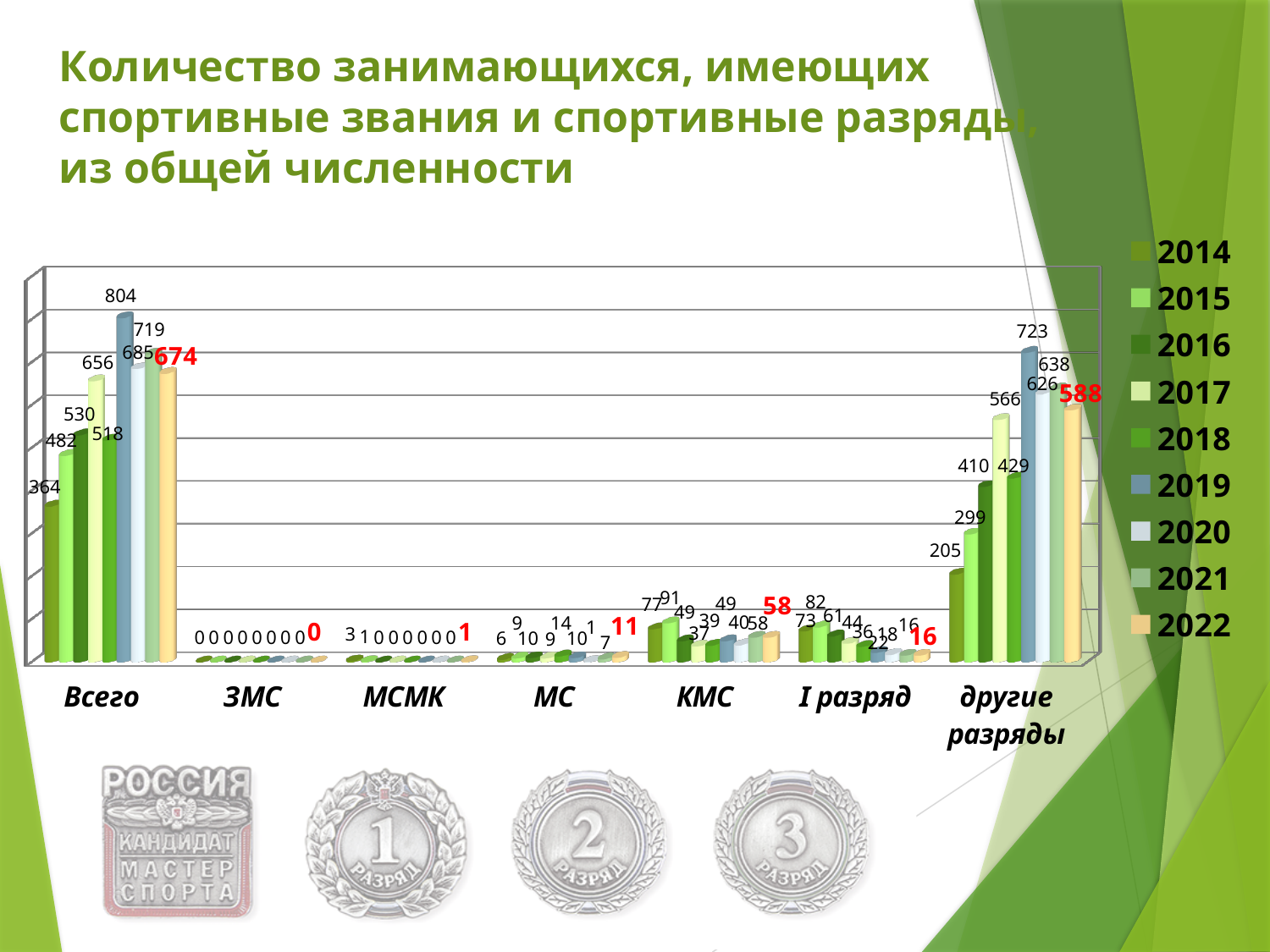
Which year has the highest value in the Всего category? 2019 How many categories are shown on the x axis? 7 What is the value for 2019 in the Всего category? 804 Which year has the lowest value in the другие разряды category? 2014 What is the value for 2022 in the Всего category? 674 How many series does the legend list? 9 In the другие разряды category, which is larger: the value for 2019 or the value for 2021? 2019 What is the value for 2014 in the другие разряды category? 205 What is the difference between the 2019 and 2014 values in the Всего category? 440 What is the value for 2014 in the КМС category? 77 What kind of chart is shown on the slide? bar chart What is the value for 2022 in the другие разряды category? 588